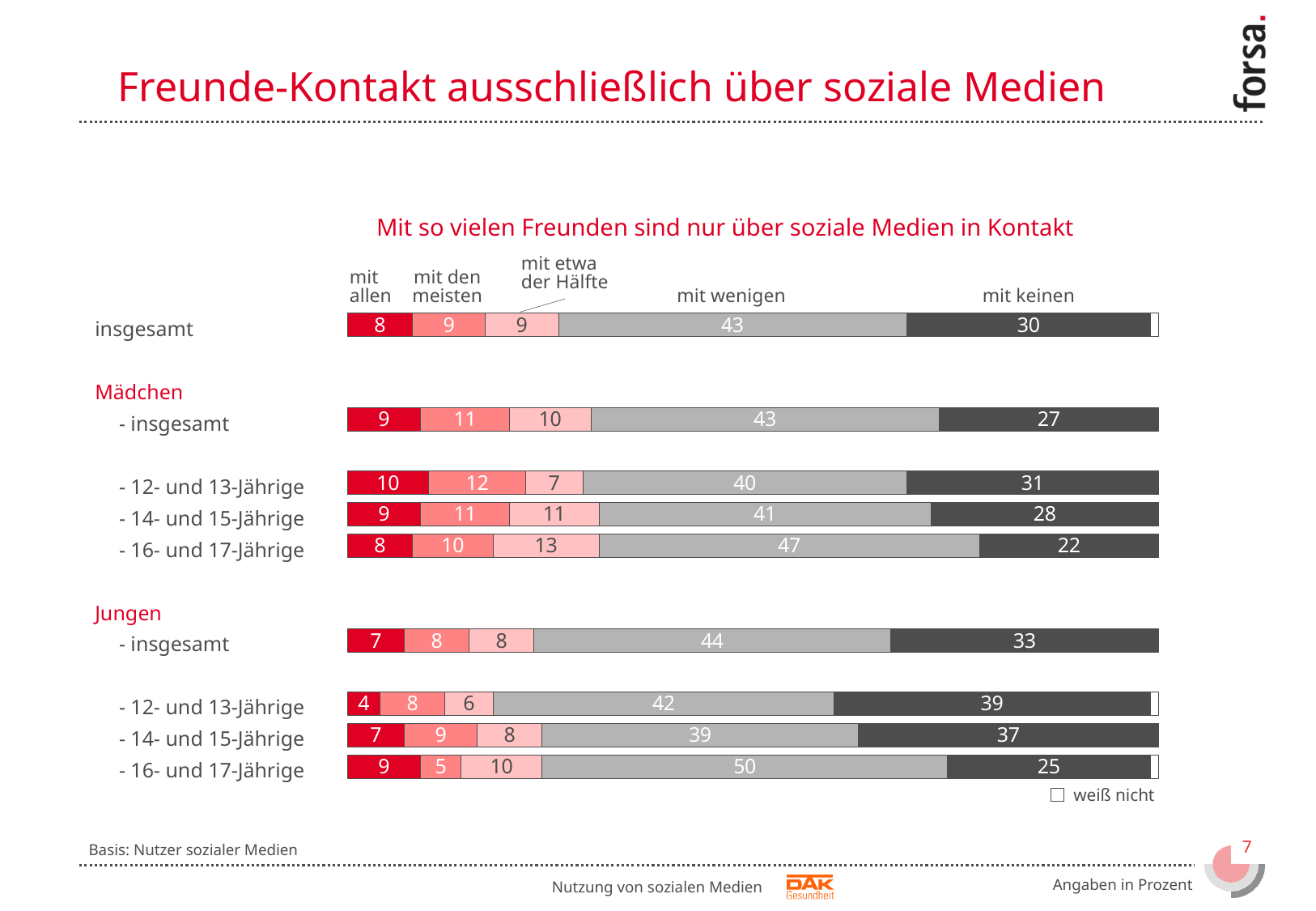
What is the subtitle printed above the chart? Mit so vielen Freunden sind nur über soziale Medien in Kontakt What is the difference between the "mit keinen" values for Jungen insgesamt and Mädchen insgesamt? 6 What is the value for "mit etwa der Hälfte" for Mädchen 16- und 17-Jährige? 13 What is the value for "mit keinen" for Jungen 12- und 13-Jährige? 39 Which group has the lowest value for "mit keinen"? Mädchen 16- und 17-Jährige Which is larger: the "mit den meisten" value for Mädchen 12- und 13-Jährige or for Jungen 16- und 17-Jährige? Mädchen 12- und 13-Jährige How many response categories are labelled above the bars (excluding "weiß nicht")? 5 What is the value for "mit wenigen" in the "insgesamt" bar? 43 What is the value for "mit allen" for Jungen 12- und 13-Jährige? 4 What kind of chart is shown on the slide? stacked bar chart Which group has the highest value for "mit wenigen"? Jungen 16- und 17-Jährige How many groups (bars) are shown in the chart? 9